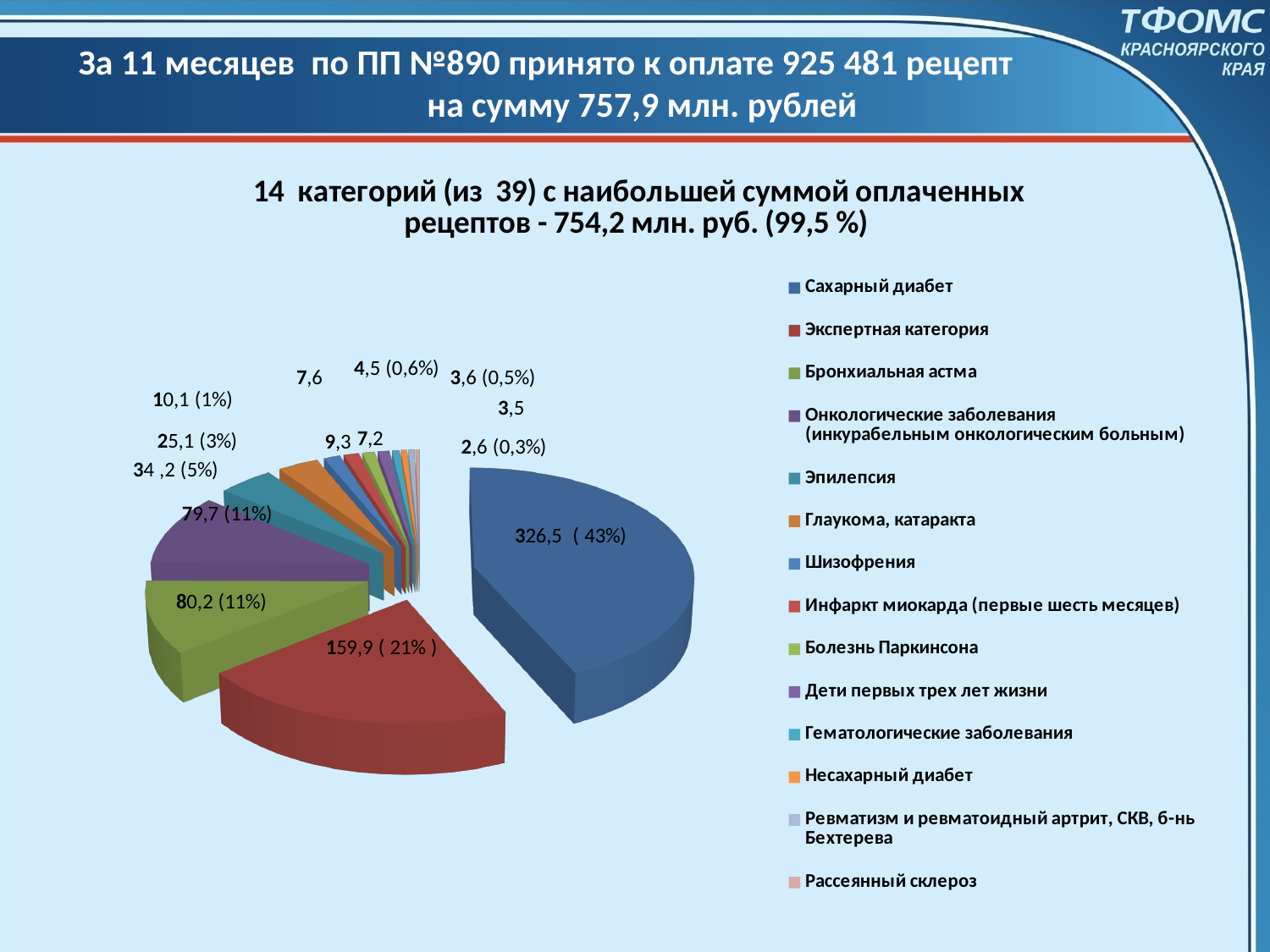
Which is larger: the Сахарный диабет slice or the Экспертная категория slice? Сахарный диабет What value is shown for the Бронхиальная астма slice? 80,2 What is the difference between the Экспертная категория slice (159,9) and the Бронхиальная астма slice (80,2)? 79,7 What kind of chart is shown on the slide? pie chart What share of the pie does Экспертная категория account for? 21% What value is shown for the largest slice (Сахарный диабет)? 326,5 What share of the pie does Сахарный диабет account for? 43% How many categories does the legend of the pie chart list? 14 What value is shown for the Экспертная категория slice? 159,9 What is the difference between the Сахарный диабет slice (326,5) and the Экспертная категория slice (159,9)? 166,6 What is the title above the pie chart? 14 категорий (из 39) с наибольшей суммой оплаченных рецептов - 754,2 млн. руб. (99,5 %) Which category has the largest slice of the pie chart? Сахарный диабет